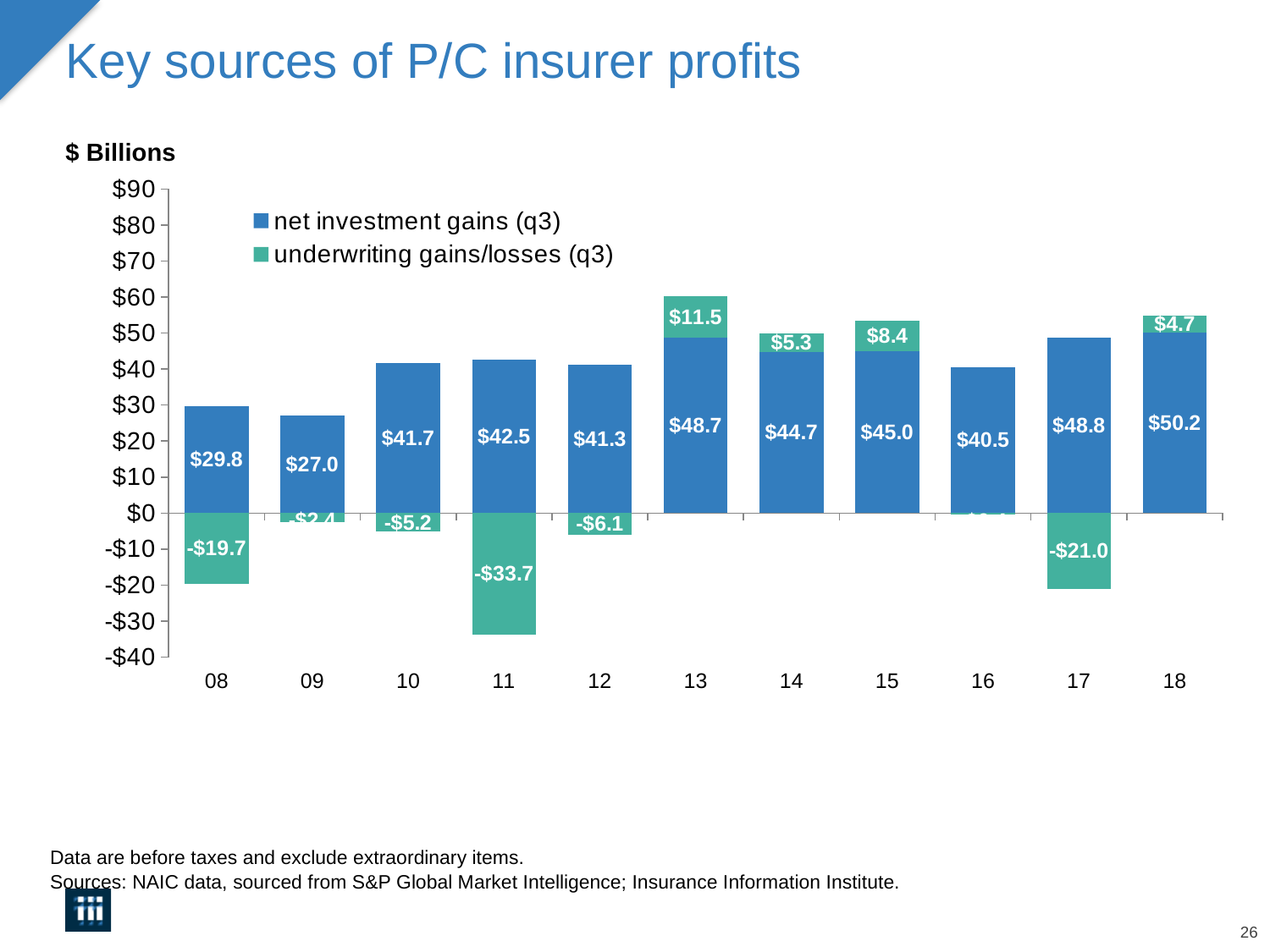
How many series does the legend list? 2 Which year has the larger underwriting gains/losses (q3), 13 or 15? 13 How many years are shown along the x axis? 11 What is the value of underwriting gains/losses (q3) for 18? $4.7 Which year has the highest net investment gains (q3)? 18 What is the total of the stacked bar for 13? $60.2 What kind of chart is shown on the slide? bar chart What is the difference between net investment gains (q3) in 18 and in 08? $20.4 What is the value of net investment gains (q3) for 13? $48.7 Which year has the lowest net investment gains (q3)? 09 Which year has the lowest underwriting gains/losses (q3)? 11 What is the value of underwriting gains/losses (q3) for 11? -$33.7